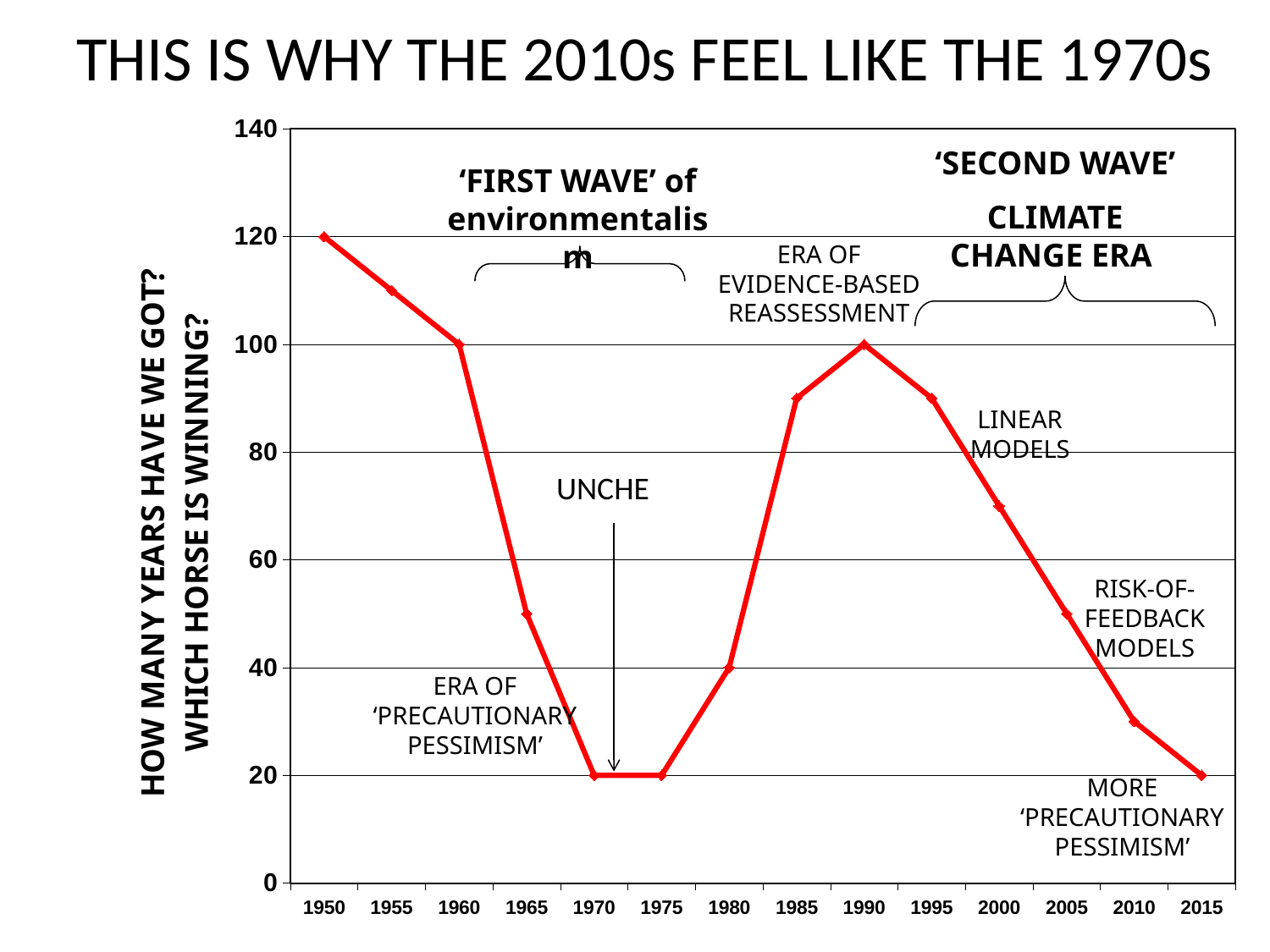
Which is larger, the value for 1950 or the value for 1990? 1950 Is the value for 1985 greater or less than 80? greater Which year has the highest plotted value? 1950 What is the value plotted for 1970? 20 What is the value plotted for 1950? 120 Do the values rise or fall between 1990 and 2015? fall What is the difference between the value for 1960 and the value for 1980? 60 What is the value plotted for 1980? 40 Is the value for 1965 greater or less than 60? less What kind of chart is shown on the slide? line chart What is the value plotted for 1990? 100 How many data points are plotted on the line? 14